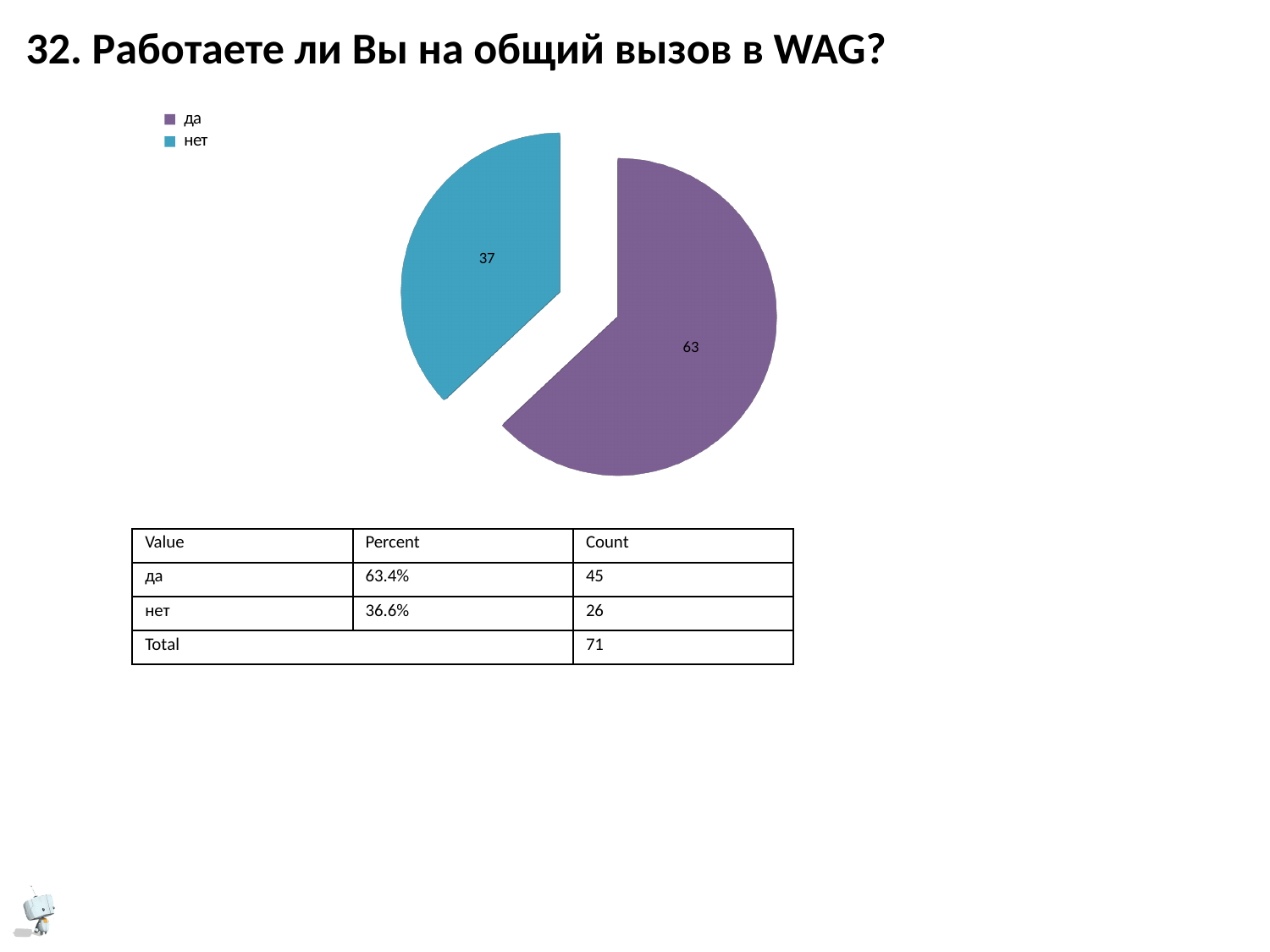
Is the value printed on the "да" slice greater or less than 50? greater Which slice of the pie chart is the smallest? нет What is the title of the slide containing the pie chart? 32. Работаете ли Вы на общий вызов в WAG? What kind of chart is shown on the slide? pie chart What value is printed on the "нет" slice of the pie chart? 37 What value is printed on the "да" slice of the pie chart? 63 How many slices does the pie chart have? 2 How many entries does the legend list? 2 Which slice is larger, "да" or "нет"? да What colour is the "нет" slice of the pie chart? blue What is the difference between the values printed on the "да" and "нет" slices? 26 Which slice of the pie chart is the largest? да